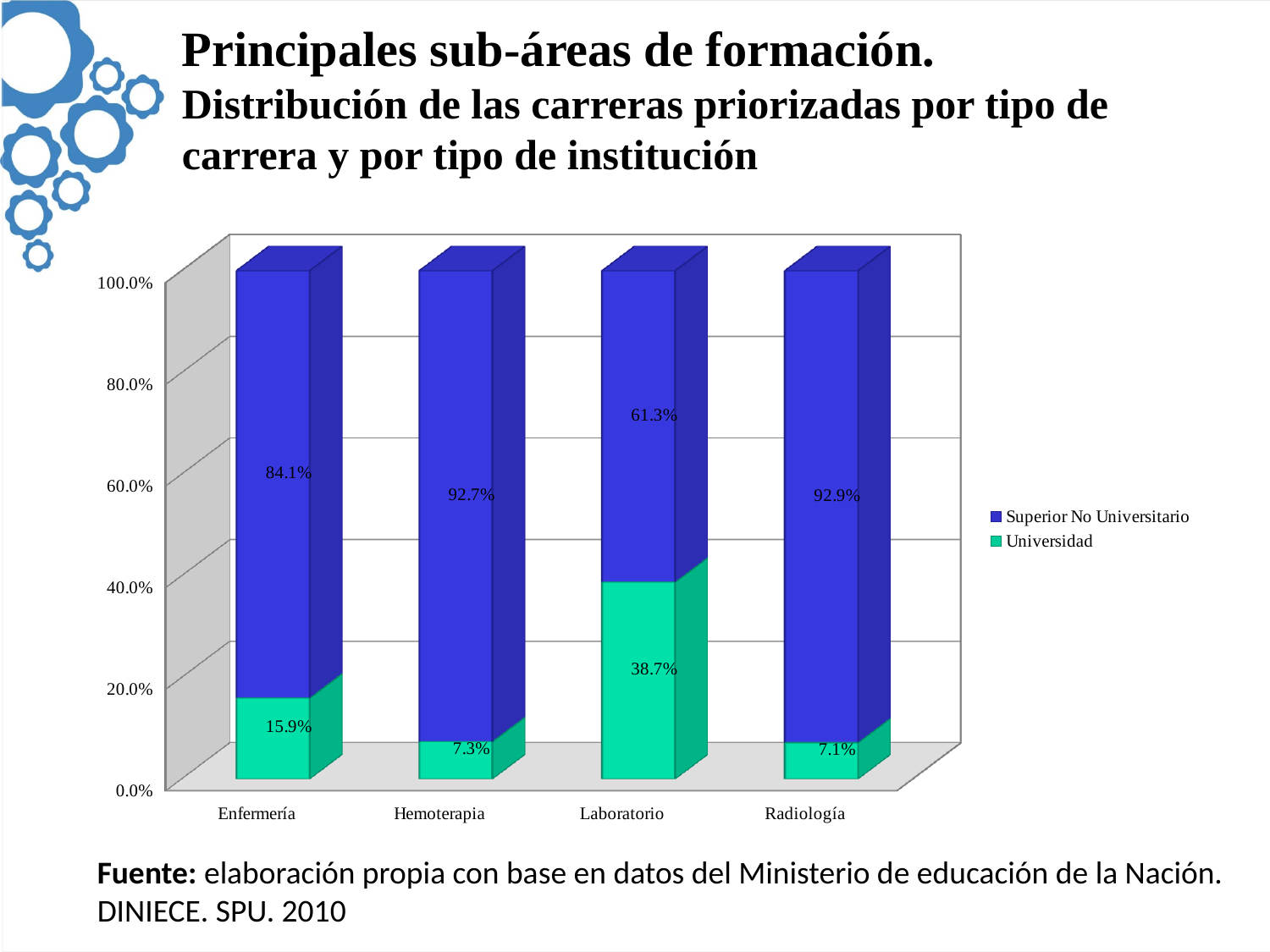
Which category has the lowest Superior No Universitario share? Laboratorio Which category has the lowest Universidad share? Radiología What is the Superior No Universitario value for Radiología? 92.9% What is the difference between the Universidad values for Laboratorio and Enfermería? 22.8% What is the Universidad value for Laboratorio? 38.7% What kind of chart is shown on the slide? Stacked bar chart What is the Superior No Universitario value for Hemoterapia? 92.7% How many series does the legend list? 2 How many categories are shown on the x axis? 4 What is the Universidad value for Enfermería? 15.9% Is the Universidad value for Enfermería or Hemoterapia larger? Enfermería Which category has the highest Universidad share? Laboratorio